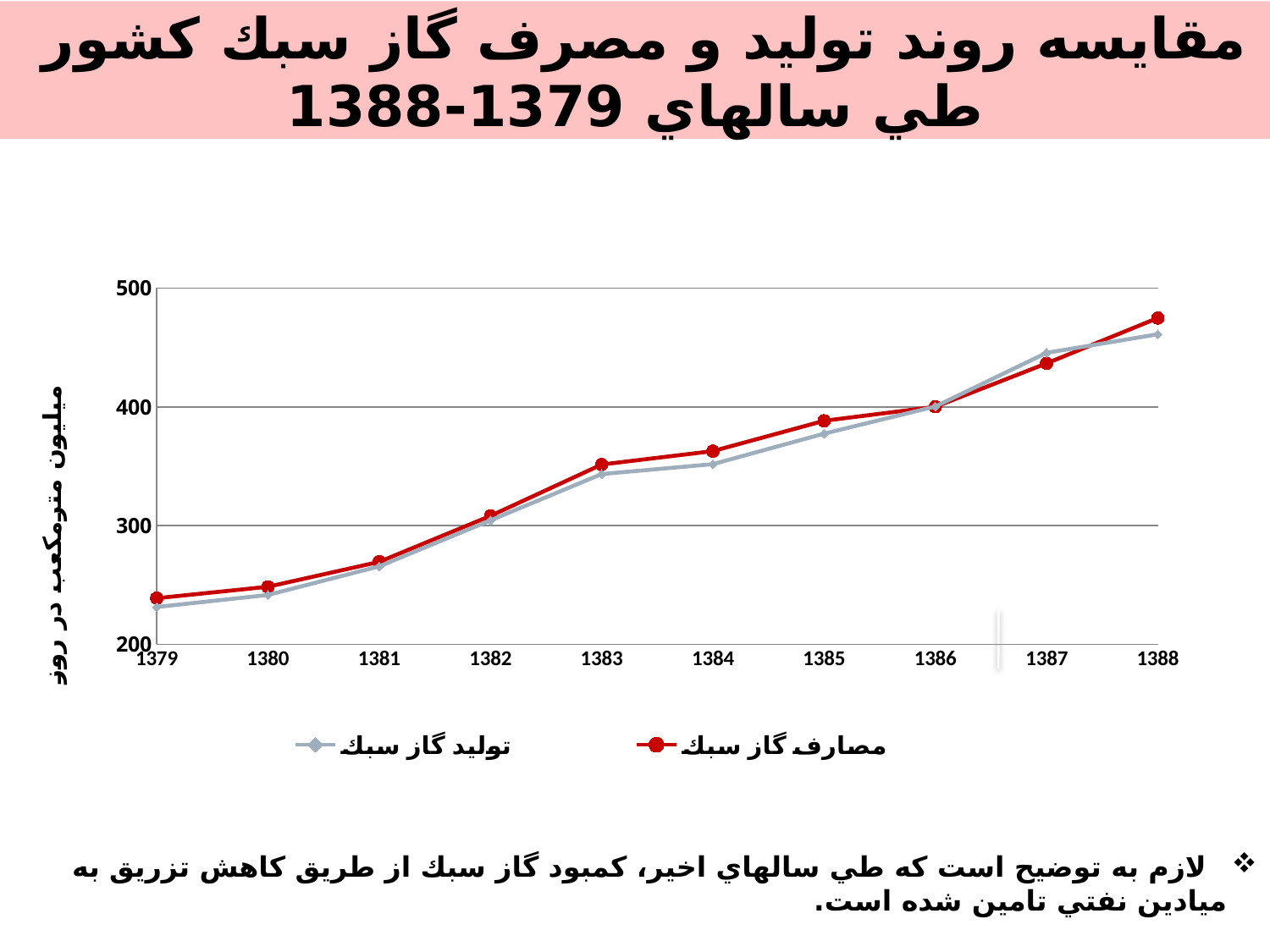
In 1385, which series has the larger value, توليد گاز سبك or مصارف گاز سبك? مصارف گاز سبك What is the label on the y axis of the chart? ميليون مترمكعب در روز Is the value for مصارف گاز سبك in 1388 greater or less than 400? greater In 1387, which series has the larger value, توليد گاز سبك or مصارف گاز سبك? توليد گاز سبك In which year is the value for توليد گاز سبك lowest? 1379 Do the values for مصارف گاز سبك rise or fall from 1379 to 1388? rise How many series does the legend list? 2 In which year is the value for مصارف گاز سبك highest? 1388 What kind of chart is shown on the slide? line chart Is the value for مصارف گاز سبك in 1383 greater or less than 300? greater Is the value for توليد گاز سبك in 1381 greater or less than 300? less How many years are plotted along the x axis? 10